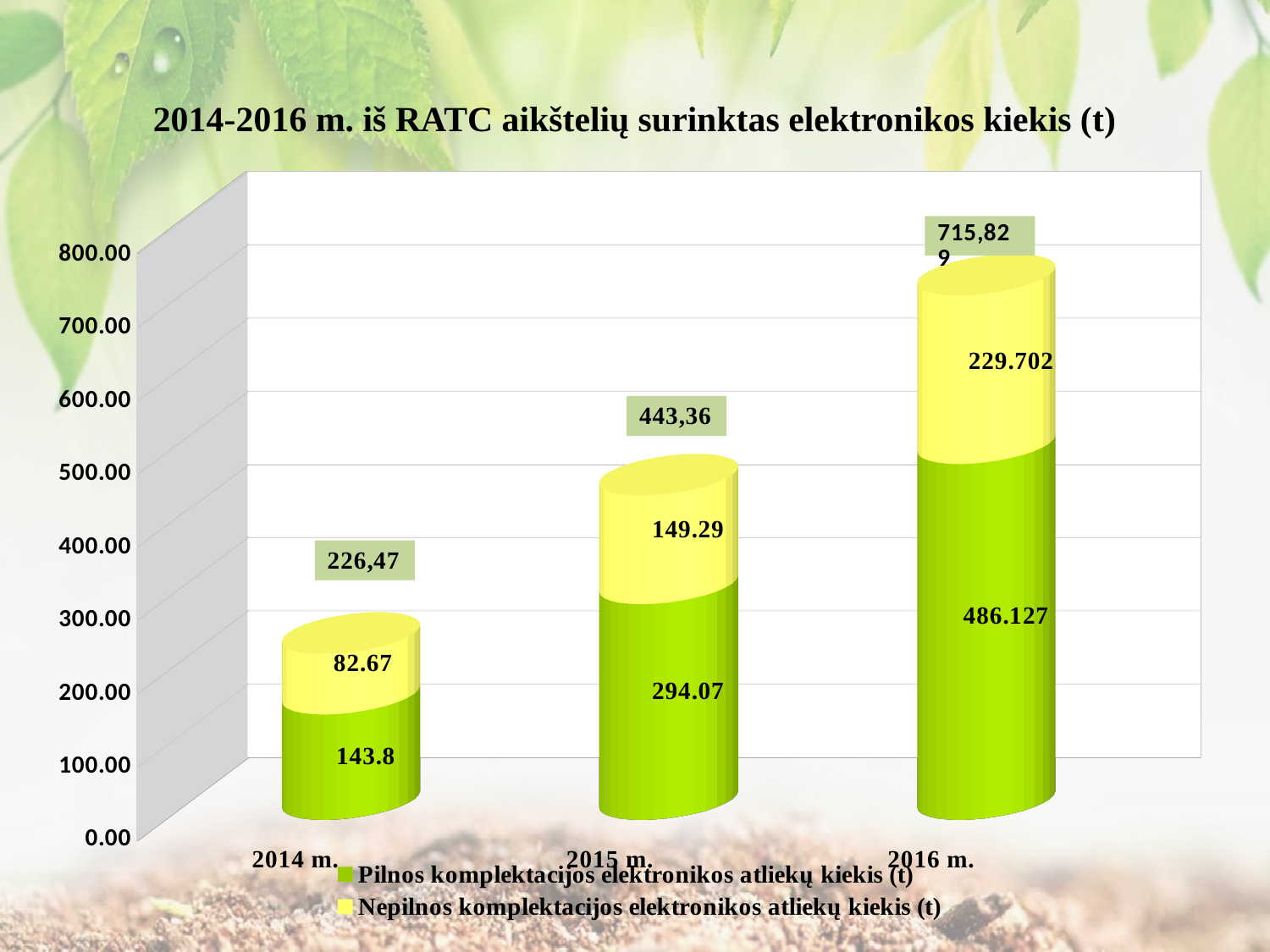
What is the total of the stacked bar for 2014 m.? 226,47 What is the total of the stacked bar for 2015 m.? 443,36 What is the value of the Nepilnos komplektacijos elektronikos atliekų kiekis (t) series for 2016 m.? 229.702 Which year has the highest value for the Pilnos komplektacijos elektronikos atliekų kiekis (t) series? 2016 m. What is the value of the Nepilnos komplektacijos elektronikos atliekų kiekis (t) series for 2015 m.? 149.29 Do the stacked bar totals rise or fall from 2014 m. to 2016 m.? rise What is the value of the Pilnos komplektacijos elektronikos atliekų kiekis (t) series for 2014 m.? 143.8 What is the difference between the Pilnos komplektacijos values for 2015 m. and 2014 m.? 150.27 Which year has the lowest value for the Nepilnos komplektacijos elektronikos atliekų kiekis (t) series? 2014 m. How many series does the legend list? 2 What is the value of the Pilnos komplektacijos elektronikos atliekų kiekis (t) series for 2016 m.? 486.127 Which is larger: the Nepilnos komplektacijos value for 2016 m. or the Pilnos komplektacijos value for 2014 m.? Nepilnos komplektacijos value for 2016 m.